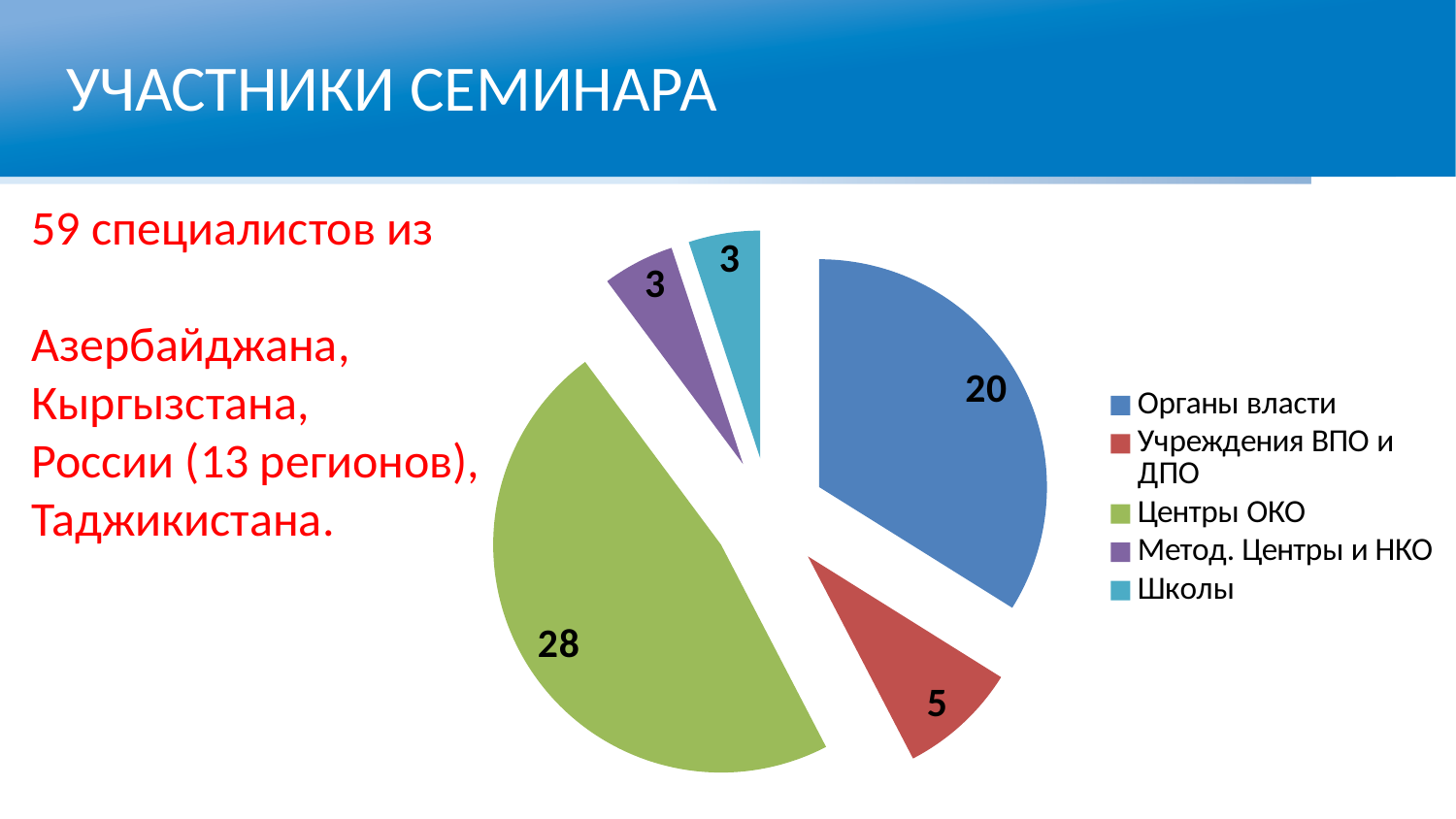
How many slices does the pie chart have? 5 Which is larger, the value for Органы власти or the value for Учреждения ВПО и ДПО? Органы власти Which category has the largest slice of the pie? Центры ОКО What is the value for Школы? 3 What kind of chart is shown on the slide? pie chart What is the total of all slices in the pie chart? 59 Which colour represents Метод. Центры и НКО in the legend? purple What fraction of the total does the Центры ОКО slice represent? 28/59 What is the value for Учреждения ВПО и ДПО? 5 What is the value for Органы власти? 20 What is the value for Центры ОКО? 28 What is the difference between the values for Центры ОКО and Органы власти? 8